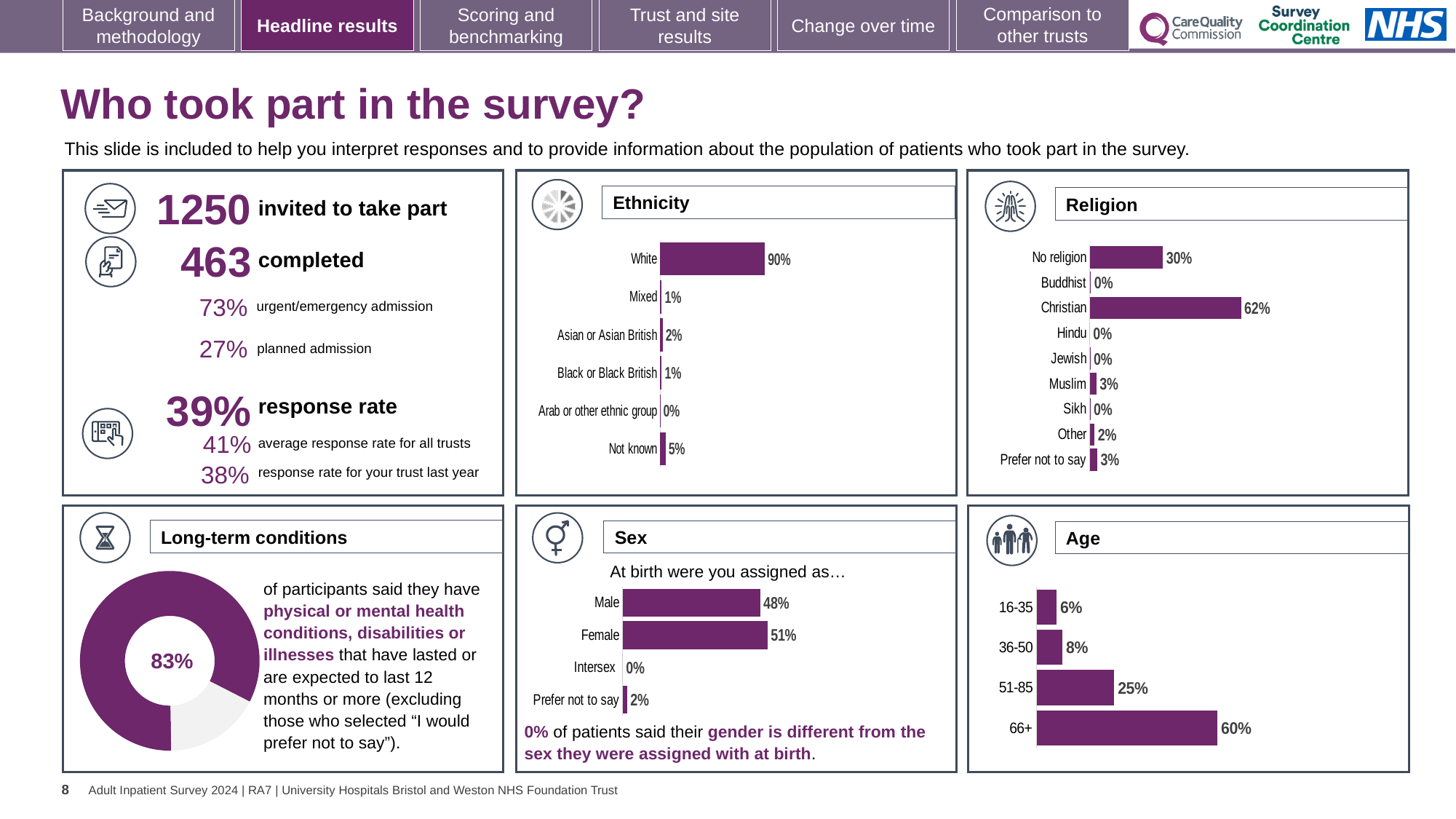
In the Religion chart, which category has the highest value? Christian In the Age chart, do the values rise or fall from 16-35 to 66+? Rise How many categories does the Age chart show? 4 In the Sex chart, what is the value for Prefer not to say? 2% In the Religion chart, what is the value for No religion? 30% In the Long-term conditions chart, what share of participants said they have long-term conditions? 83% In the Sex chart, which is larger, Male or Female? Female In the Age chart, what is the difference between the 66+ and 51-85 values? 35% What kind of chart is the Long-term conditions chart? Doughnut chart In the Ethnicity chart, what is the value for Not known? 5% How many categories does the Religion chart show? 9 In the Ethnicity chart, what percentage of respondents were White? 90%